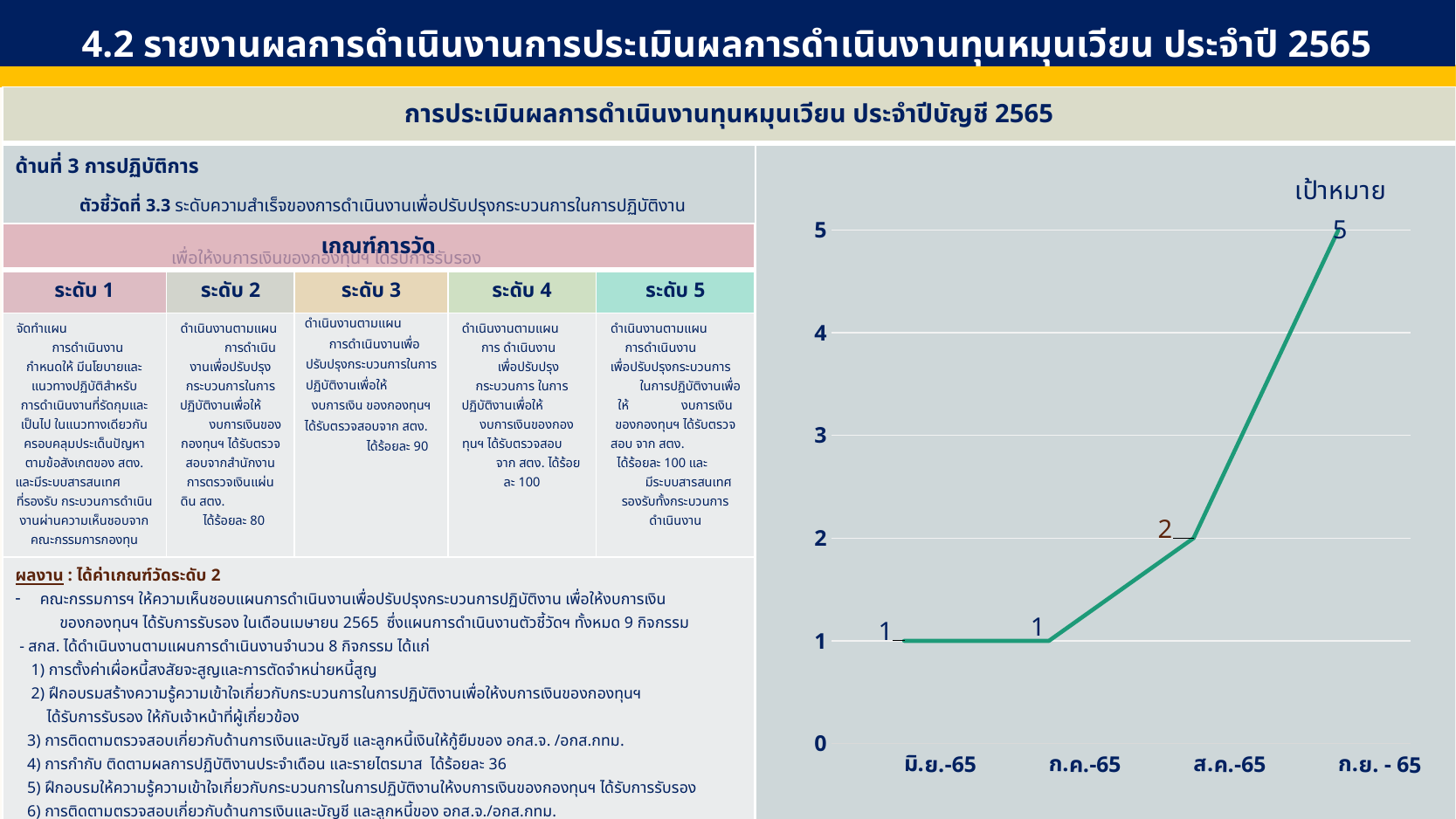
What is the difference between the values for ก.ย. - 65 and ส.ค.-65? 3 What type of chart is shown on the right side of the slide? line chart Which month has the highest value on the chart? ก.ย. - 65 What is the value plotted for ส.ค.-65? 2 How many months are shown on the x axis of the chart? 4 What is the value plotted for มิ.ย.-65? 1 What is the difference between the values for ส.ค.-65 and ก.ค.-65? 1 Do the values on the chart rise or fall from มิ.ย.-65 to ก.ย. - 65? rise What is the value plotted for ก.ย. - 65? 5 What is the value plotted for ก.ค.-65? 1 Which is larger, the value for ส.ค.-65 or the value for มิ.ย.-65? ส.ค.-65 What label appears at the top right of the chart above the last point? เป้าหมาย